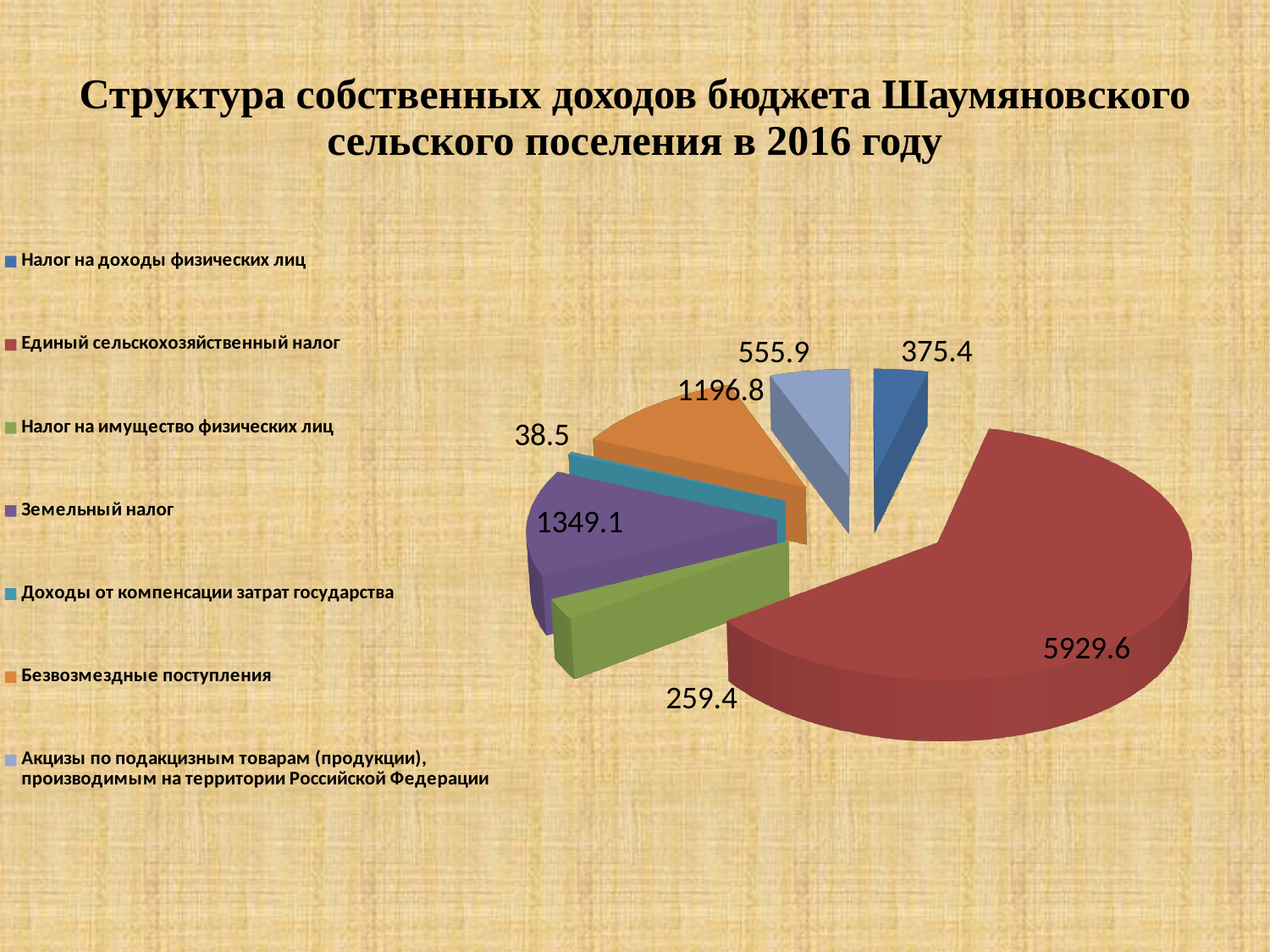
What is the difference between the values for Акцизы по подакцизным товарам and Налог на доходы физических лиц? 180.5 What is the difference between the values for Единый сельскохозяйственный налог and Земельный налог? 4580.5 How many slices does the pie chart have? 7 Which category has the smallest slice of the pie? Доходы от компенсации затрат государства What is the value for Доходы от компенсации затрат государства? 38.5 What is the value for Земельный налог? 1349.1 What is the value for Единый сельскохозяйственный налог? 5929.6 What type of chart is shown on the slide? pie chart What colour is the slice for Налог на имущество физических лиц? green Which is larger: Земельный налог or Безвозмездные поступления? Земельный налог What is the value for Безвозмездные поступления? 1196.8 Which category has the largest slice of the pie? Единый сельскохозяйственный налог